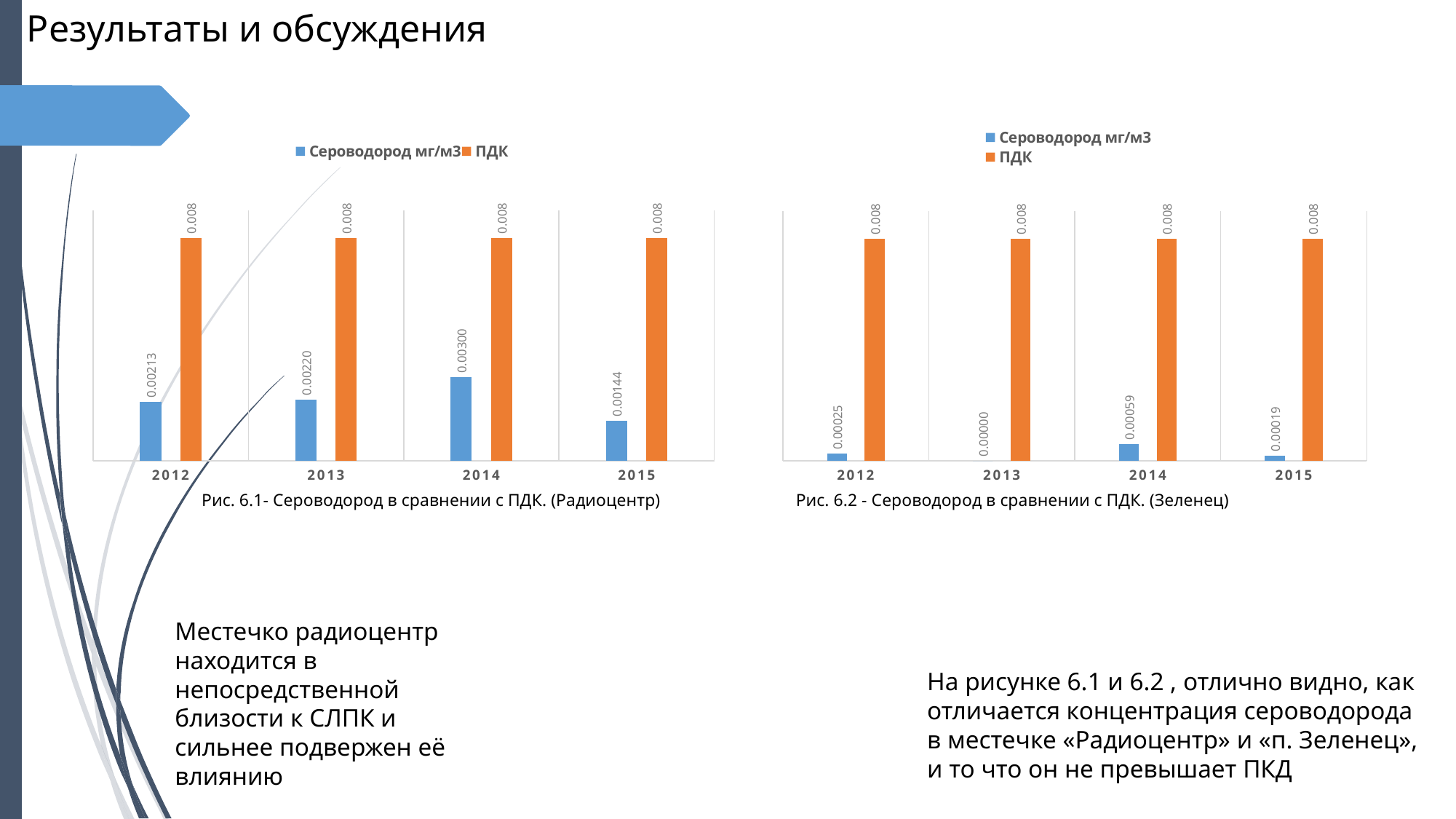
In the chart captioned Рис. 6.2 (Зеленец), how many series does the legend list? 2 In the chart captioned Рис. 6.1 (Радиоцентр), which year has the highest Сероводород мг/м3 value? 2014 In the chart captioned Рис. 6.1 (Радиоцентр), what is the value of Сероводород мг/м3 for 2014? 0.00300 In the chart captioned Рис. 6.2 (Зеленец), what is the value of ПДК for 2015? 0.008 What type of chart is the one captioned Рис. 6.1 (Радиоцентр)? Bar chart In the chart captioned Рис. 6.2 (Зеленец), what is the value of Сероводород мг/м3 for 2013? 0.00000 In the chart captioned Рис. 6.2 (Зеленец), which year has the lowest Сероводород мг/м3 value? 2013 In the chart captioned Рис. 6.1 (Радиоцентр), what is the value of Сероводород мг/м3 for 2015? 0.00144 In the chart captioned Рис. 6.1 (Радиоцентр), how many years are shown on the x axis? 4 In the chart captioned Рис. 6.1 (Радиоцентр), what is the difference between the Сероводород мг/м3 values for 2014 and 2015? 0.00156 In the chart captioned Рис. 6.2 (Зеленец), what is the value of Сероводород мг/м3 for 2014? 0.00059 In the chart captioned Рис. 6.2 (Зеленец), which is larger, the Сероводород мг/м3 value for 2012 or for 2014? 2014